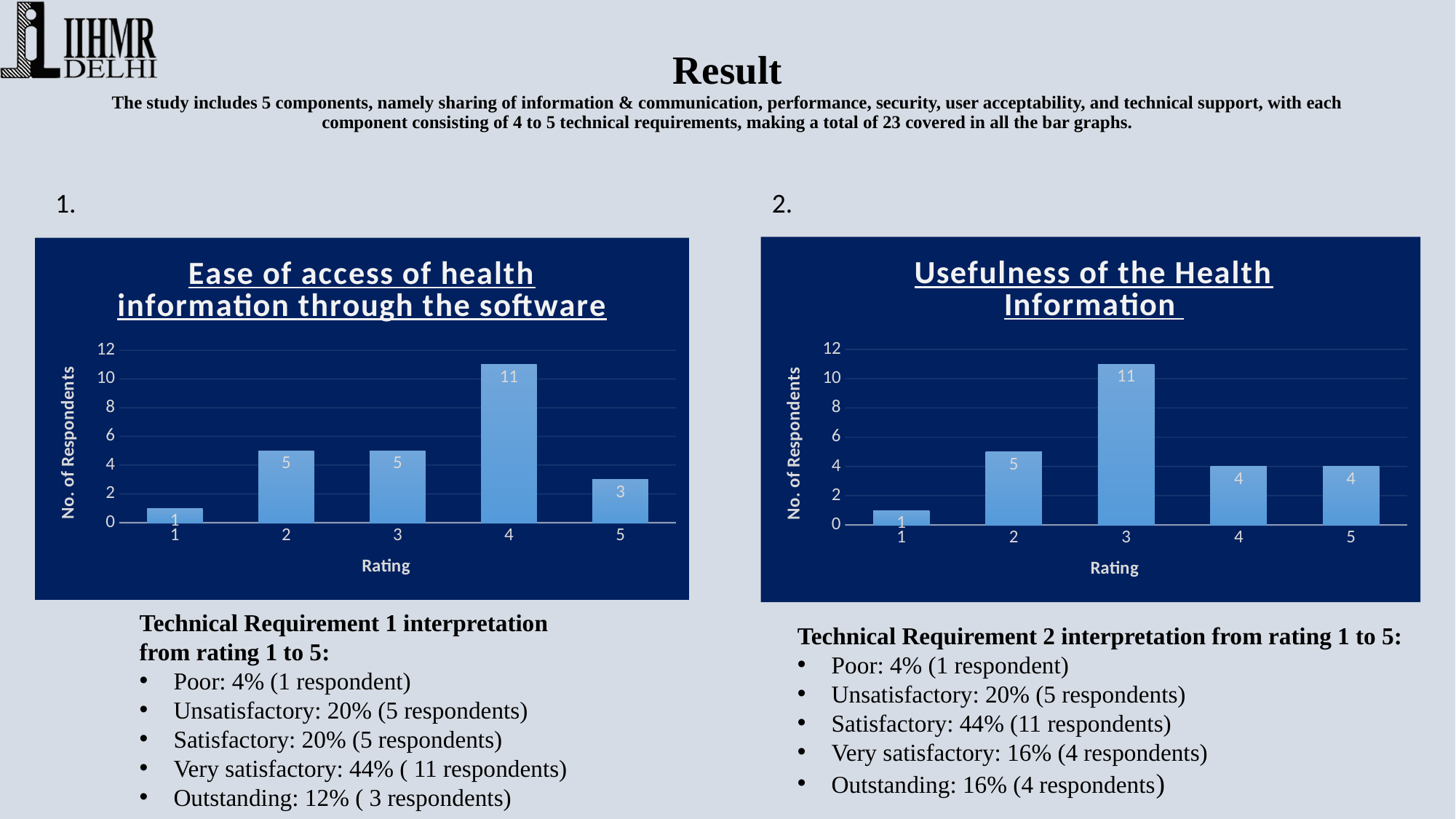
In the 'Ease of access of health information through the software' chart, which rating has the highest number of respondents? 4 In the 'Ease of access of health information through the software' chart, how many respondents gave a rating of 4? 11 In the 'Usefulness of the Health Information' chart, how many respondents gave a rating of 2? 5 In the 'Usefulness of the Health Information' chart, how many respondents gave a rating of 3? 11 In the 'Usefulness of the Health Information' chart, which rating has the highest number of respondents? 3 In the 'Usefulness of the Health Information' chart, is the number of respondents for rating 3 greater or less than 10? greater In the 'Ease of access of health information through the software' chart, what is the difference between the number of respondents for rating 4 and rating 2? 6 What type of chart is the 'Usefulness of the Health Information' chart? Bar chart In the 'Ease of access of health information through the software' chart, which rating has the lowest number of respondents? 1 In the 'Ease of access of health information through the software' chart, how many respondents gave a rating of 5? 3 In the 'Ease of access of health information through the software' chart, how many rating categories are shown on the x axis? 5 In the 'Usefulness of the Health Information' chart, which has more respondents: rating 2 or rating 4? Rating 2